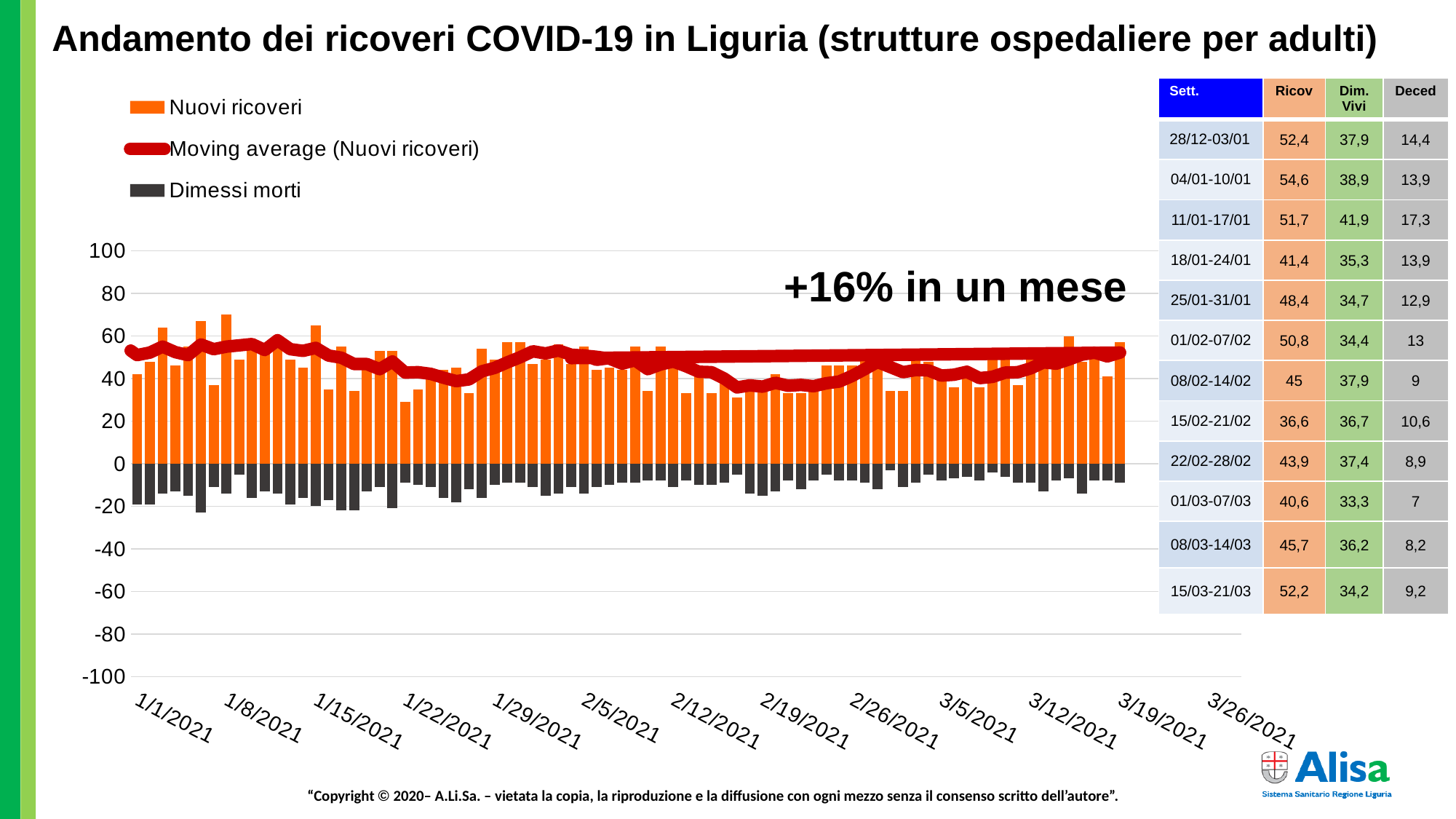
How many series does the chart legend list? 3 Is the highest Nuovi ricoveri bar greater or less than 60? greater What kind of chart is used to show Nuovi ricoveri and Dimessi morti? bar chart (with a moving average line) What is the title of the chart? Andamento dei ricoveri COVID-19 in Liguria (strutture ospedaliere per adulti) Is the highest Nuovi ricoveri bar greater or less than 80? less What annotation is printed in large text over the chart? +16% in un mese Does the Moving average (Nuovi ricoveri) line rise or fall between 1/29/2021 and 2/19/2021? fall Is the value for Nuovi ricoveri on 1/1/2021 greater or less than 60? less Does the Moving average (Nuovi ricoveri) line rise or fall between 2/19/2021 and 3/19/2021? rise How many date labels are shown on the x axis of the chart? 13 Which is larger, the Nuovi ricoveri value on 1/1/2021 or on 1/8/2021? 1/8/2021